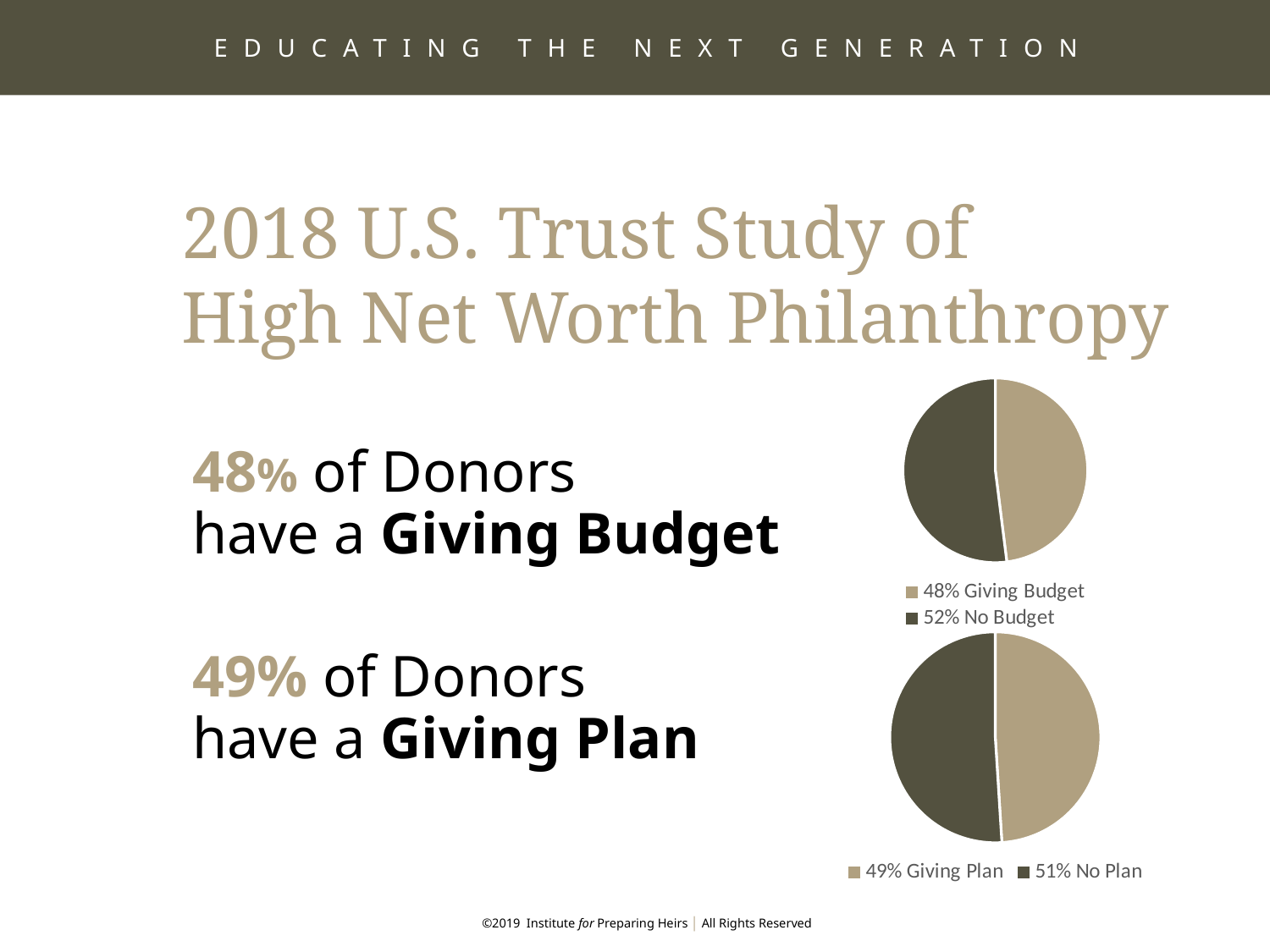
In the top pie chart, what share of donors have a Giving Budget? 48% In the bottom pie chart, what share of donors have No Plan? 51% In the top pie chart, which slice is larger: Giving Budget or No Budget? No Budget In the top pie chart, what is the difference between the No Budget share and the Giving Budget share? 4% In the bottom pie chart, which slice is the largest? No Plan In the top pie chart, what share of donors have No Budget? 52% What kind of chart is the bottom chart on the right side of the slide? pie chart How many slices does the top pie chart have? 2 What kind of chart is the top chart on the right side of the slide? pie chart How many entries does the legend of the bottom pie chart list? 2 In the bottom pie chart, what is the difference between the No Plan share and the Giving Plan share? 2%